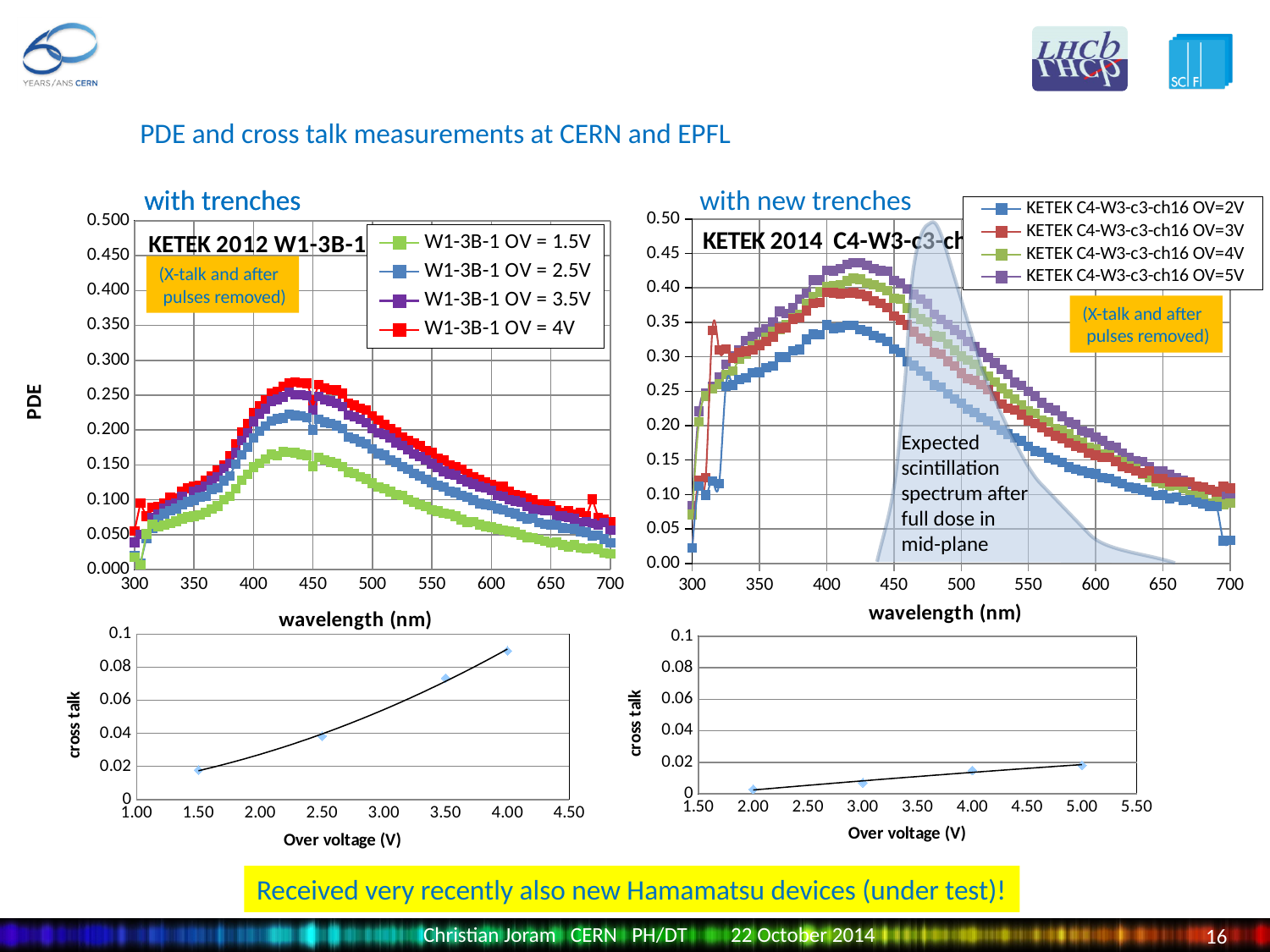
In the top-right PDE chart (with new trenches), is the peak value of the KETEK C4-W3-c3-ch16 OV=2V series greater or less than 0.40? less What is the title shown inside the top-left PDE chart? KETEK 2012 W1-3B-1 In the top-left PDE chart (with trenches), is the value of the W1-3B-1 OV = 4V series at 700 nm greater or less than 0.100? less What kind of chart is the top-left PDE chart (with trenches)? line chart In the top-right PDE chart (with new trenches), do the PDE values rise or fall as wavelength increases from 450 nm to 700 nm? fall In the bottom-left cross talk chart, how many data points are plotted? 4 In the top-left PDE chart (with trenches), how many series does the legend list? 4 In the top-right PDE chart (with new trenches), how many series does the legend list? 4 In the top-right PDE chart (with new trenches), is the peak value of the KETEK C4-W3-c3-ch16 OV=5V series greater or less than 0.40? greater